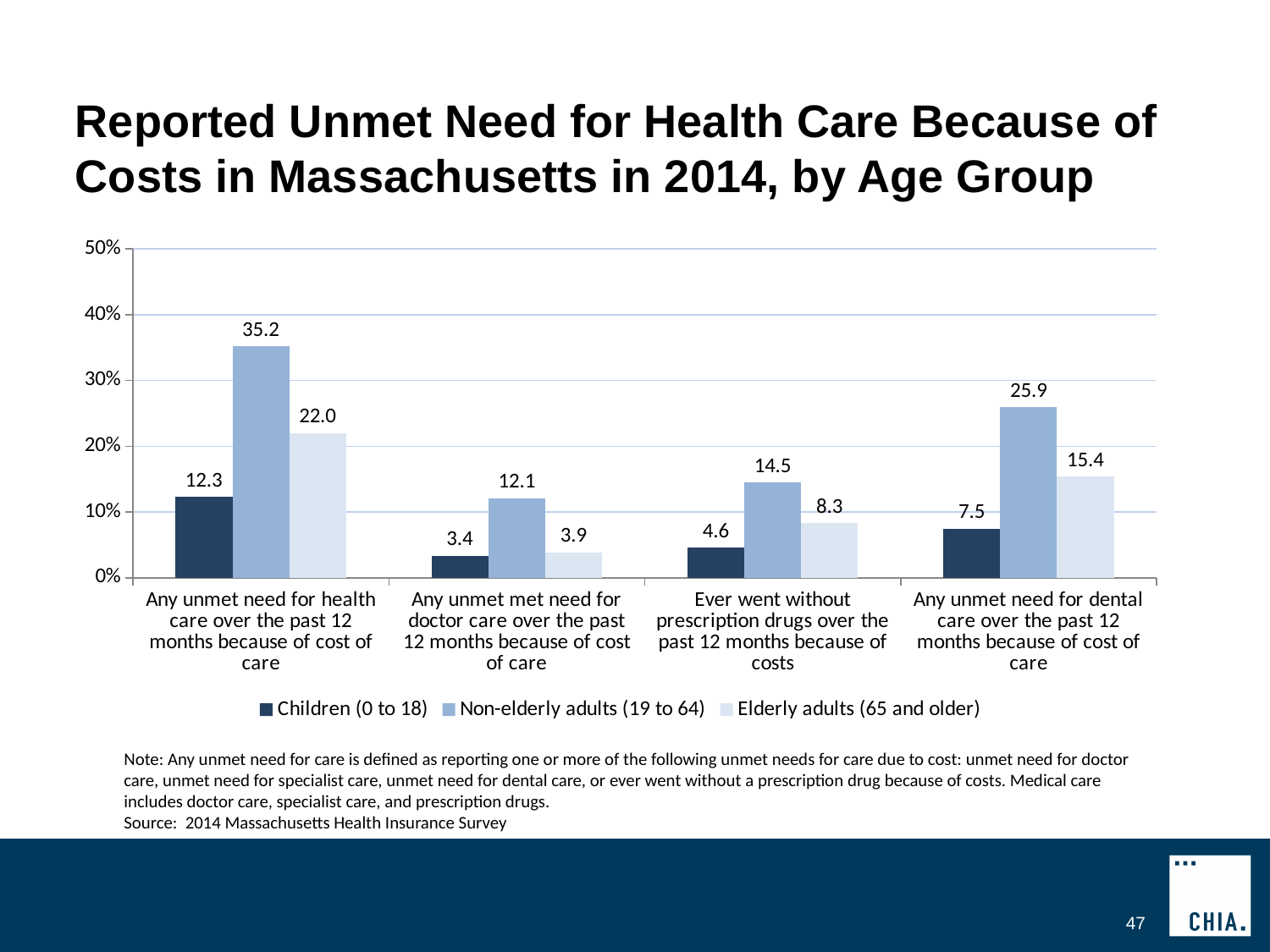
What is the value for Elderly adults (65 and older) for 'Any unmet need for dental care over the past 12 months because of cost of care'? 15.4 How many series does the legend list? 3 What is the value for Non-elderly adults (19 to 64) for 'Any unmet need for health care over the past 12 months because of cost of care'? 35.2 How many categories are shown on the x axis? 4 What is the difference between the Non-elderly adults (19 to 64) and Elderly adults (65 and older) values for 'Any unmet need for health care over the past 12 months because of cost of care'? 13.2 Is the Non-elderly adults (19 to 64) value for 'Ever went without prescription drugs over the past 12 months because of costs' greater or less than 10%? greater What is the value for Children (0 to 18) for 'Ever went without prescription drugs over the past 12 months because of costs'? 4.6 What kind of chart is shown on the slide? Bar chart Which is larger: the Children (0 to 18) value for 'Any unmet need for health care over the past 12 months because of cost of care' or the Children (0 to 18) value for 'Any unmet need for dental care over the past 12 months because of cost of care'? Any unmet need for health care over the past 12 months because of cost of care What is the source cited for the chart? 2014 Massachusetts Health Insurance Survey Which age group has the lowest value for 'Any unmet met need for doctor care over the past 12 months because of cost of care'? Children (0 to 18) Which age group has the highest value for 'Any unmet need for dental care over the past 12 months because of cost of care'? Non-elderly adults (19 to 64)